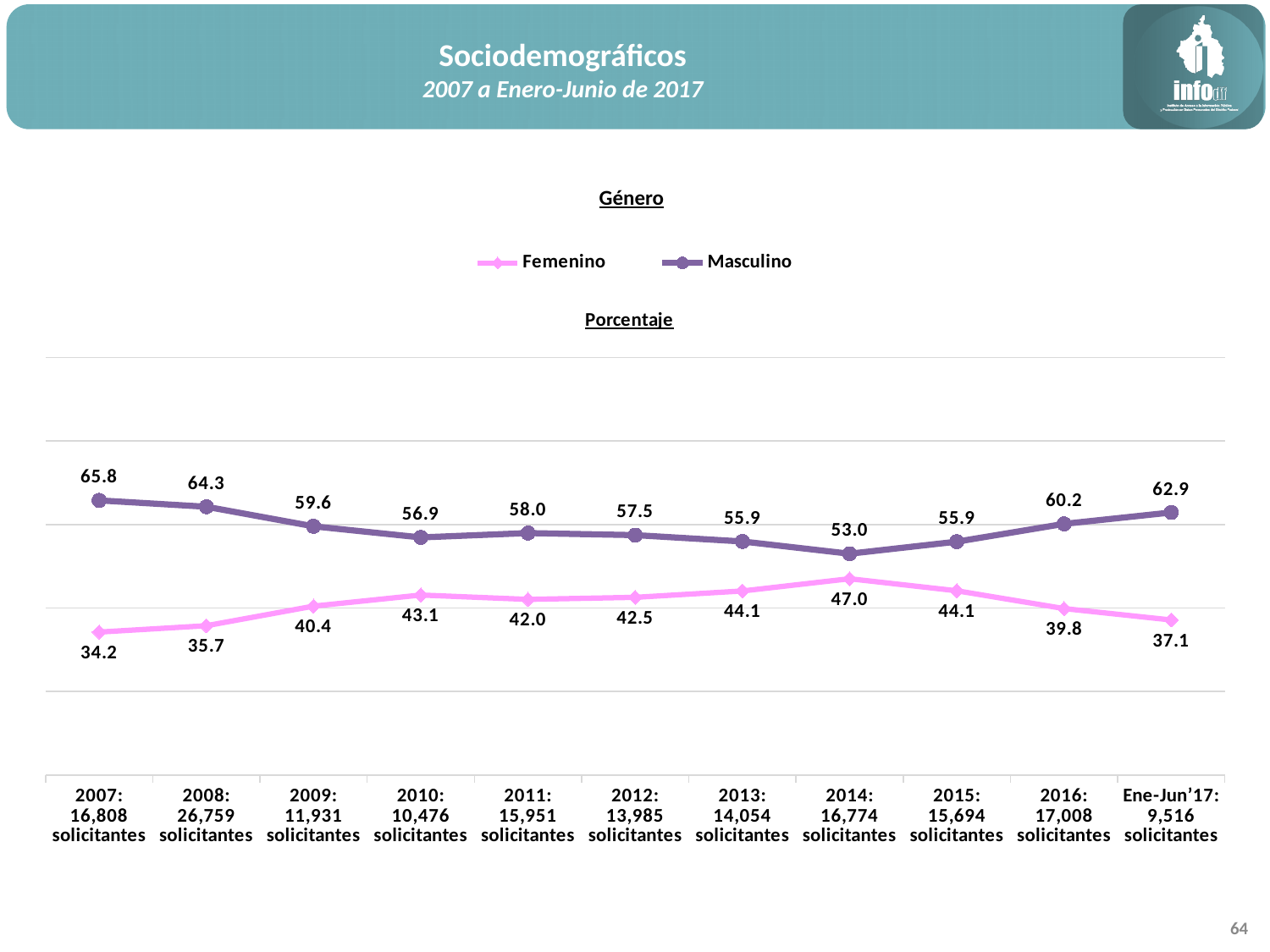
How many time periods are shown on the x axis? 11 In 2016, which series has the larger value, Femenino or Masculino? Masculino Does the Femenino series rise or fall from 2007 to 2014? Rise What is the Masculino percentage for 2007? 65.8 What is the Femenino percentage for 2014? 47.0 What kind of chart is shown on the slide? Line chart How many series does the legend list? 2 In which year is the Femenino series at its lowest value? 2007 In which year is the Masculino series at its lowest value? 2014 In which year does the Femenino series reach its highest value? 2014 What is the difference between the Masculino and Femenino percentages in 2014? 6.0 What is the difference between the Masculino and Femenino percentages in 2007? 31.6